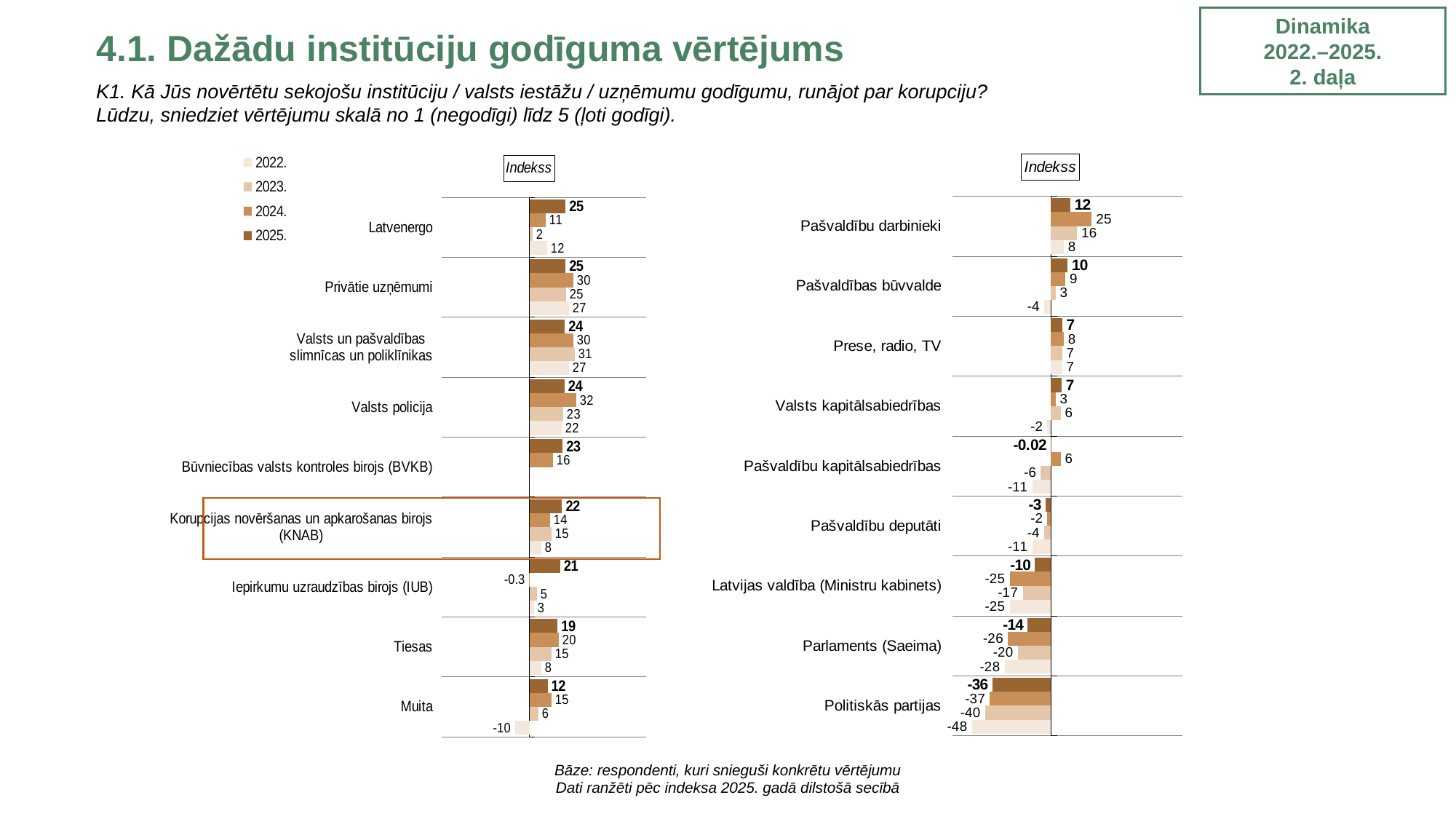
In the right chart, what is the difference between the 2022 and 2025 index values for Parlaments (Saeima)? 14 In the left chart, what is the 2022 index value for Muita? -10 In the right chart, what is the 2023 index value for Pašvaldību darbinieki? 16 In the right chart, which institution has the lowest 2025 index value? Politiskās partijas How many institutions are shown in the right chart? 9 In the right chart, what is the 2025 index value for Politiskās partijas? -36 In the left chart, which is larger for Tiesas: the 2025 value or the 2024 value? 2024 In the left chart, which institution has the lowest 2025 index value? Muita What type of chart is used on this slide? Bar chart In the left chart, what is the difference between the 2025 and 2022 index values for Korupcijas novēršanas un apkarošanas birojs (KNAB)? 14 How many series does the legend list? 4 In the left chart, what is the 2025 index value for Latvenergo? 25